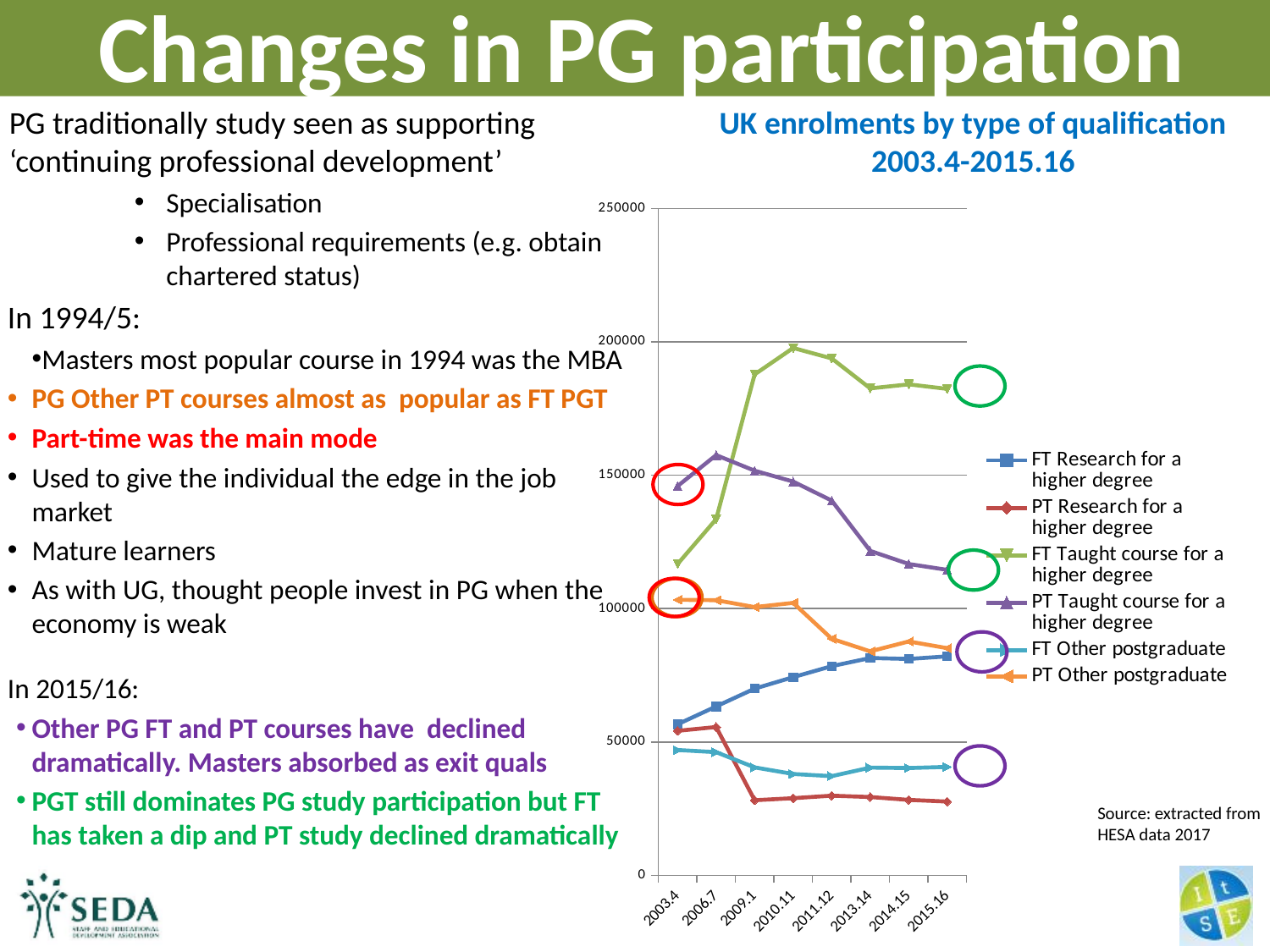
Is the value for PT Other postgraduate in 2015.16 greater or less than 100000? less Which series has the highest value in 2015.16? FT Taught course for a higher degree Which series has the highest value in 2003.4? PT Taught course for a higher degree What is the title of the chart? UK enrolments by type of qualification 2003.4-2015.16 In 2015.16, which is larger: FT Taught course for a higher degree or PT Taught course for a higher degree? FT Taught course for a higher degree Which series has the lowest value in 2015.16? PT Research for a higher degree What kind of chart is shown on the slide? line chart How many academic years are plotted along the x axis? 8 Is the value for FT Taught course for a higher degree in 2015.16 greater or less than 150000? greater Does the FT Research for a higher degree series rise or fall from 2003.4 to 2015.16? rise How many series does the chart legend list? 6 Is the value for PT Research for a higher degree in 2015.16 greater or less than 50000? less